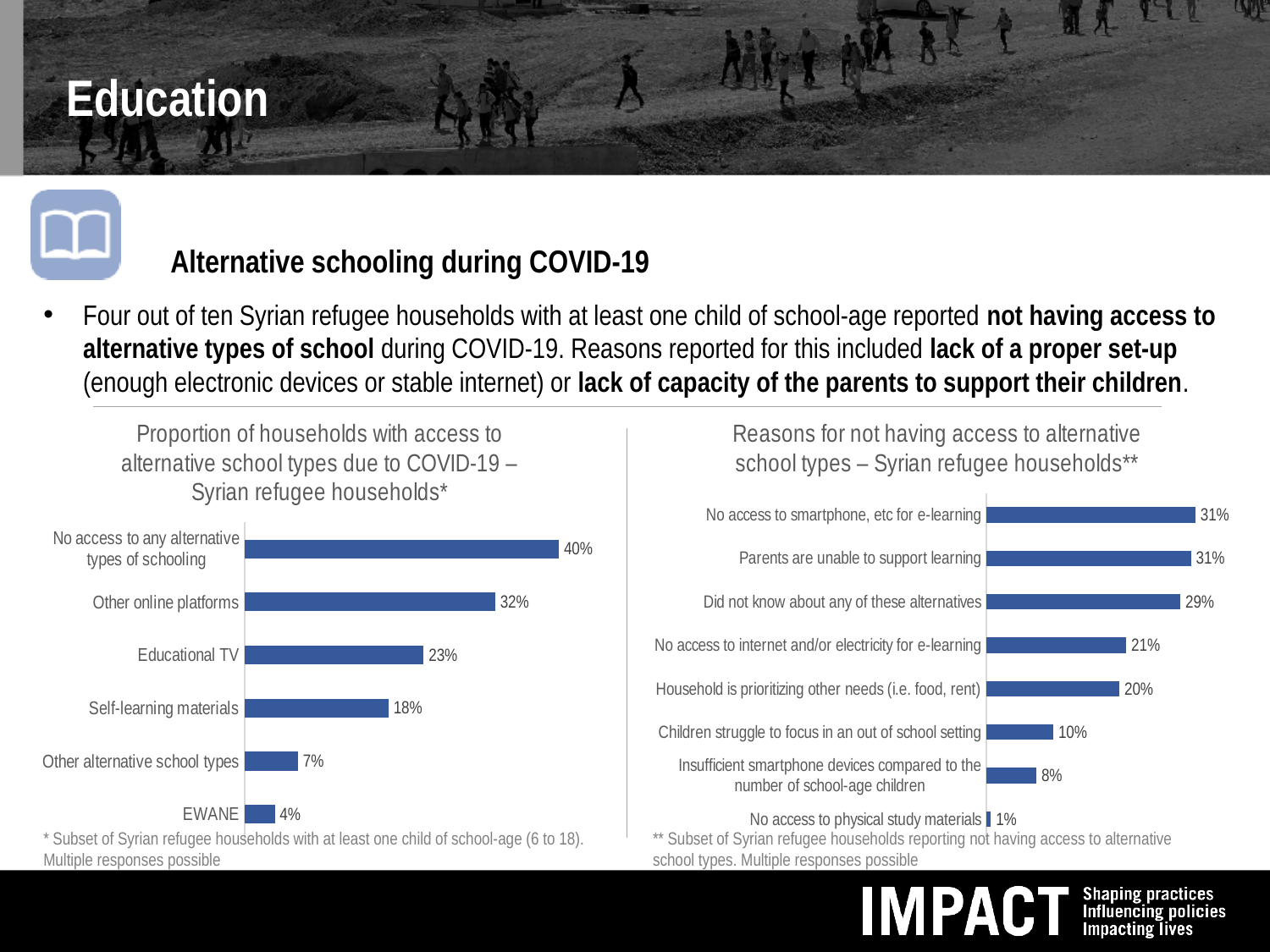
In the right chart (Reasons for not having access to alternative school types), what is the value for No access to physical study materials? 1% In the right chart (Reasons for not having access to alternative school types), which is larger: Children struggle to focus in an out of school setting or Insufficient smartphone devices compared to the number of school-age children? Children struggle to focus in an out of school setting In the right chart (Reasons for not having access to alternative school types), what is the value for Household is prioritizing other needs (i.e. food, rent)? 20% In the right chart (Reasons for not having access to alternative school types), what is the difference between Did not know about any of these alternatives and No access to internet and/or electricity for e-learning? 8% In the left chart (Proportion of households with access to alternative school types due to COVID-19), what is the value for Educational TV? 23% In the left chart (Proportion of households with access to alternative school types due to COVID-19), which category has the lowest value? EWANE In the left chart (Proportion of households with access to alternative school types due to COVID-19), how many categories are shown? 6 In the right chart (Reasons for not having access to alternative school types), how many categories are shown? 8 What type of chart is the right chart (Reasons for not having access to alternative school types)? Bar chart In the left chart (Proportion of households with access to alternative school types due to COVID-19), what is the difference between Other online platforms and Self-learning materials? 14% In the right chart (Reasons for not having access to alternative school types), which category has the lowest value? No access to physical study materials In the left chart (Proportion of households with access to alternative school types due to COVID-19), which is larger: Other alternative school types or Self-learning materials? Self-learning materials